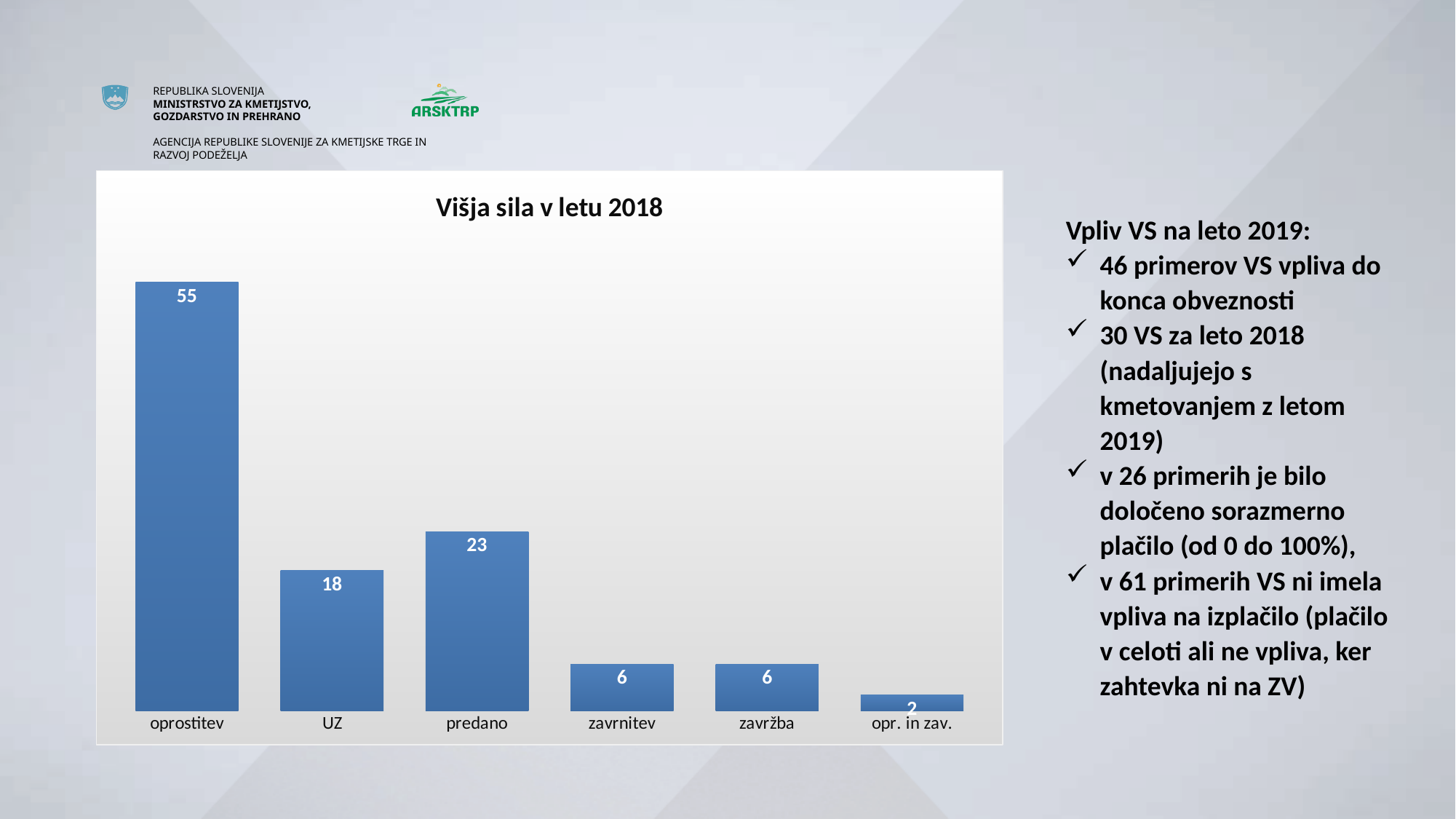
Which category has the highest value? oprostitev Which category has the lowest value? opr. in zav. What is the difference between the values for oprostitev and predano? 32 What is the value for zavrnitev? 6 What is the value for oprostitev? 55 What is the value for opr. in zav.? 2 What is the title of the chart? Višja sila v letu 2018 Which is larger, the value for UZ or the value for predano? predano What is the value for UZ? 18 What is the value for predano? 23 How many categories are shown in the chart? 6 What kind of chart is shown on the slide? bar chart